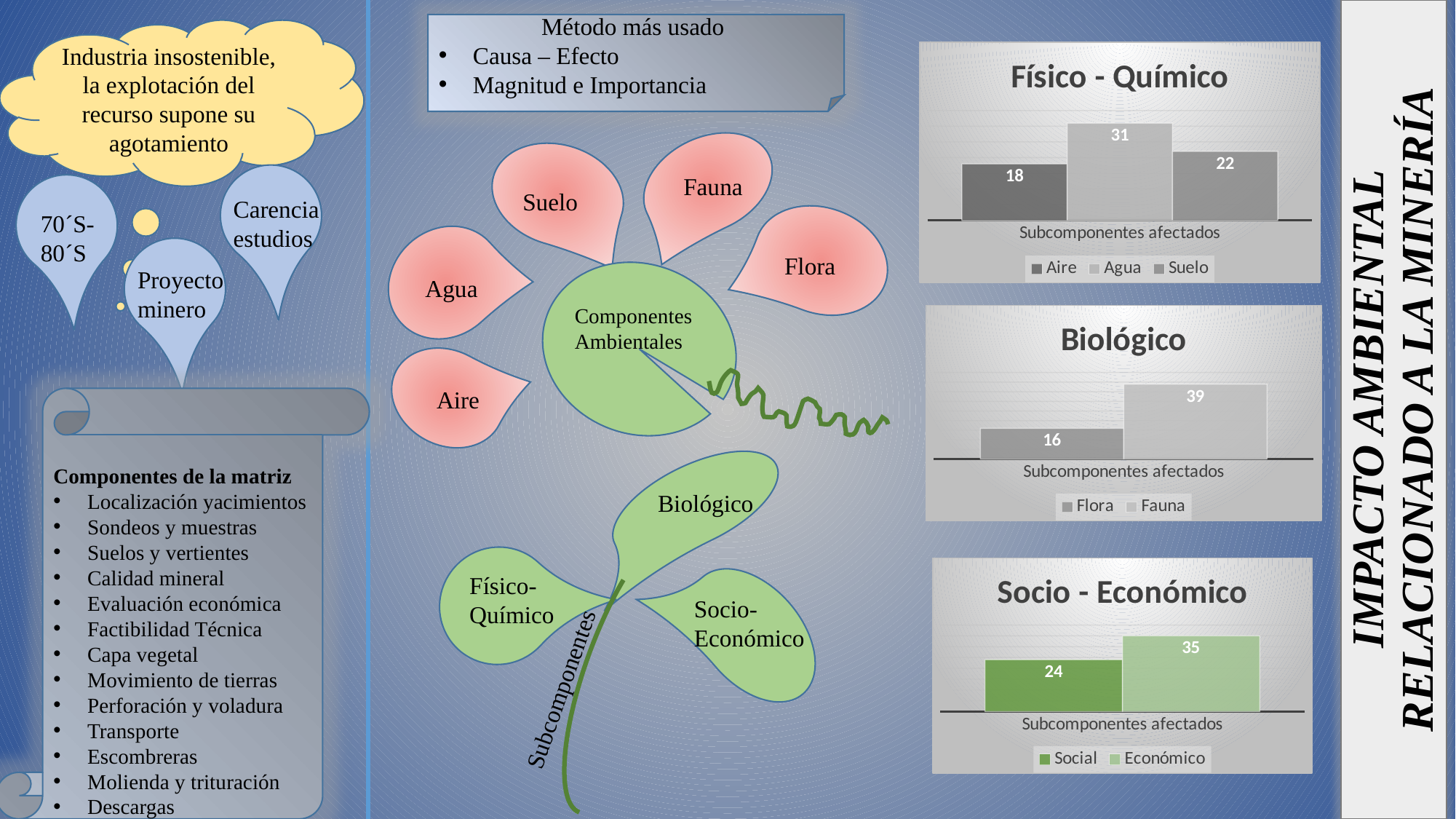
In the 'Socio - Económico' chart, what is the value for Social? 24 What is the x-axis label shown under the bars in the 'Socio - Económico' chart? Subcomponentes afectados In the 'Socio - Económico' chart, which series has the highest value? Económico In the 'Físico - Químico' chart, how many series does the legend list? 3 In the 'Biológico' chart, what is the value for Fauna? 39 In the 'Socio - Económico' chart, what is the difference between the values for Económico and Social? 11 In the 'Físico - Químico' chart, what is the value for Agua? 31 In the 'Biológico' chart, which is larger, Flora or Fauna? Fauna What kind of chart is the 'Biológico' chart? bar chart In the 'Físico - Químico' chart, what is the difference between the values for Agua and Aire? 13 In the 'Físico - Químico' chart, which series has the lowest value? Aire In the 'Biológico' chart, what is the difference between the values for Fauna and Flora? 23